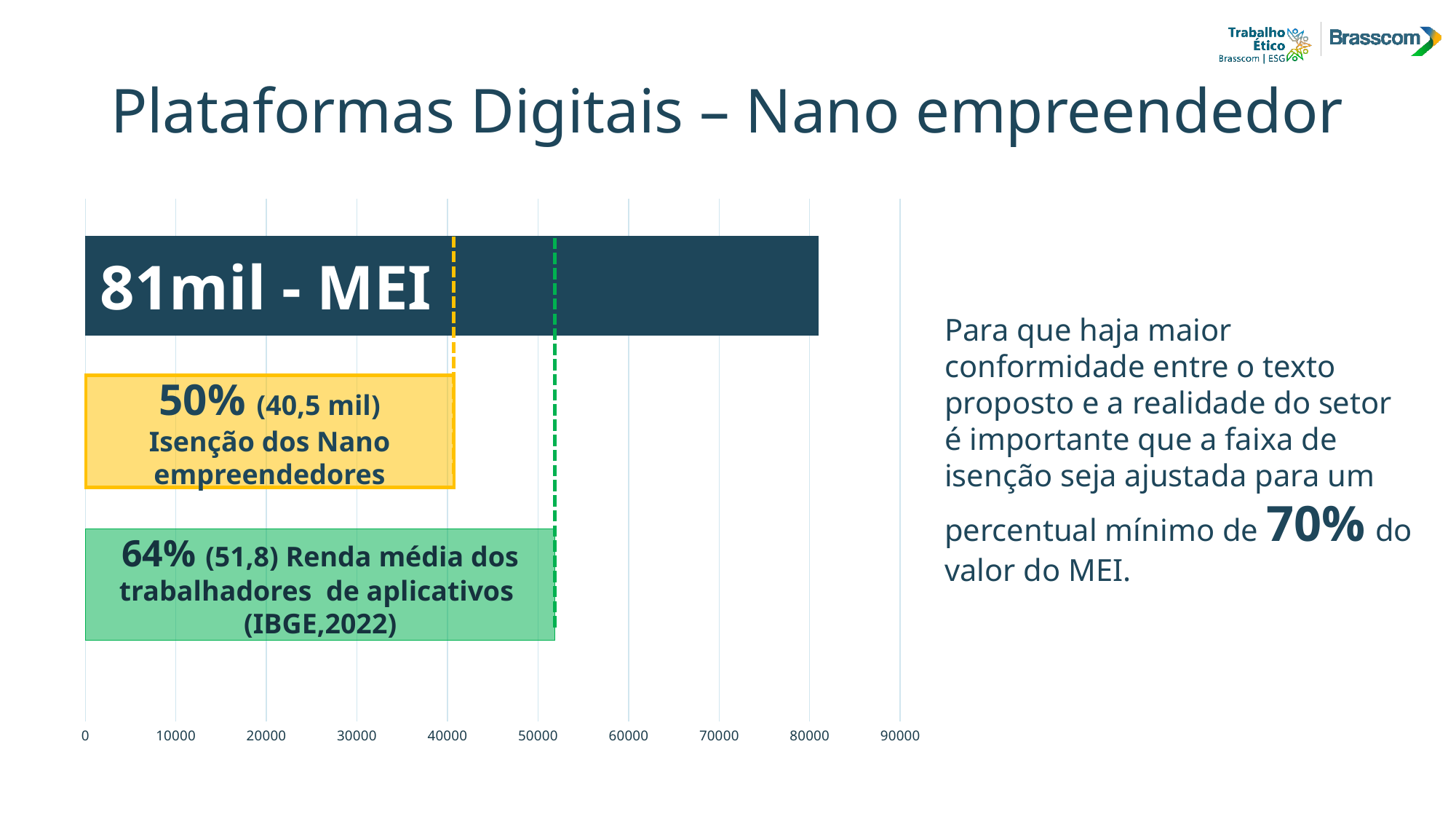
What percentage is shown for the 'Isenção dos Nano empreendedores' bar? 50% Which bar is longer: 'Isenção dos Nano empreendedores' or 'Renda média dos trabalhadores de aplicativos'? Renda média dos trabalhadores de aplicativos What is the difference between the MEI value (81mil) and the Isenção dos Nano empreendedores value (40,5 mil)? 40,5 mil What percentage is shown for the 'Renda média dos trabalhadores de aplicativos' bar? 64% Is the value for the MEI bar greater or less than 70000? greater Which bar in the chart is the longest? 81mil - MEI Is the value for the 'Isenção dos Nano empreendedores' bar greater or less than 50000? less What value is printed on the longest bar of the chart? 81mil - MEI How many bars does the chart show? 3 What value in thousands is shown in parentheses for the 'Isenção dos Nano empreendedores' bar? 40,5 mil What kind of chart is shown on the slide? Bar chart Which bar in the chart is the shortest? Isenção dos Nano empreendedores